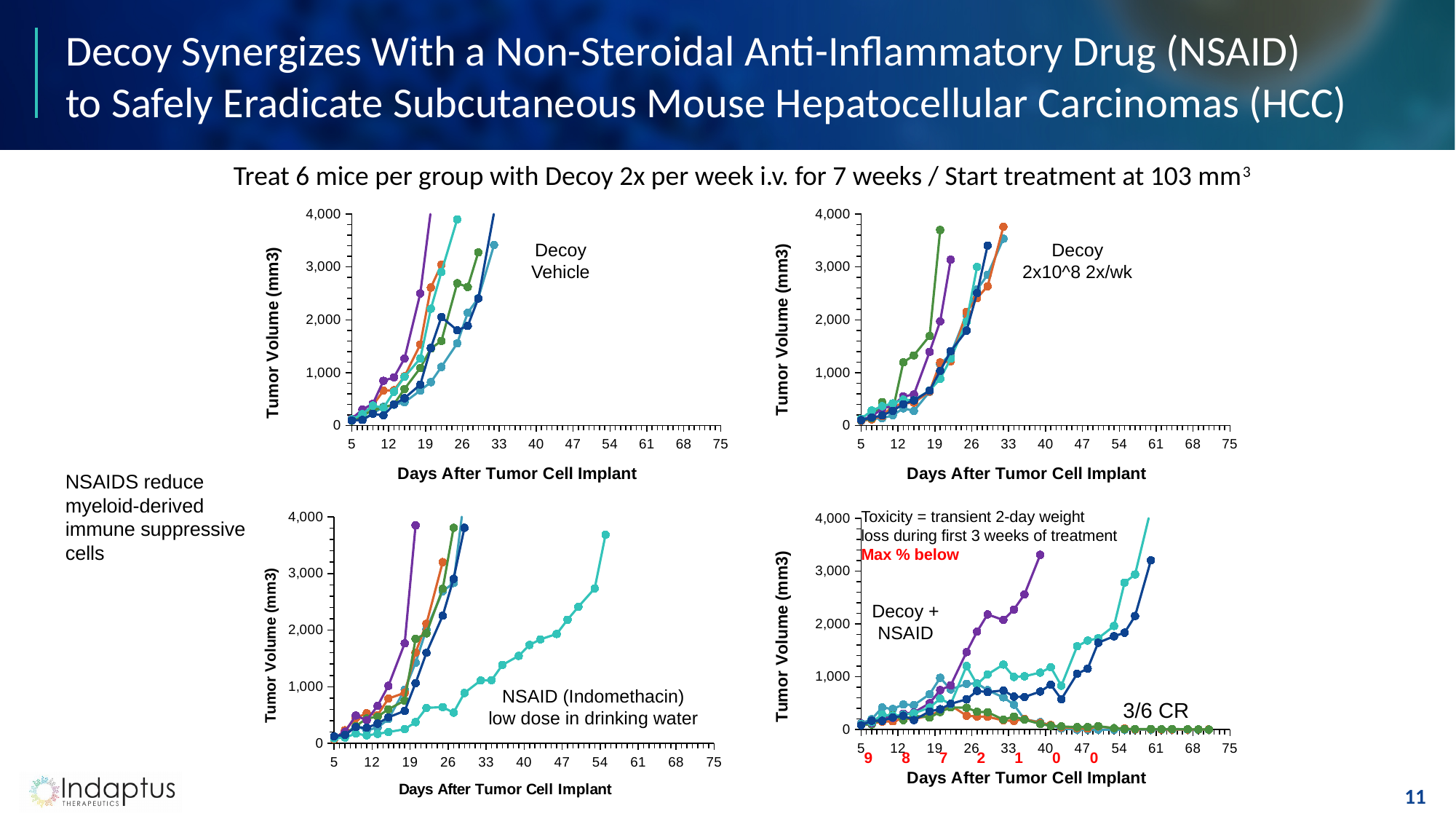
What kind of chart is the Decoy Vehicle chart at the top left? line chart In the Decoy + NSAID chart, what is the smallest of the red maximum % weight loss values printed below the x axis? 0 In the NSAID (Indomethacin) chart, is the final value of the teal line near day 54 greater or less than 3,000? greater In the Decoy + NSAID chart, is the value of the green line at day 68 greater or less than 1,000? less What is the highest value shown on the y axis of the Decoy + NSAID chart? 4,000 In the Decoy + NSAID chart, what is the first red maximum % weight loss value printed below the x axis? 9 What is the y-axis label on the Decoy 2x10^8 2x/wk chart? Tumor Volume (mm3) How many charts are shown on the slide? 4 In the Decoy + NSAID chart, is the highest point of the purple line greater or less than 3,000? greater In the Decoy + NSAID chart, how many complete responses (CR) are reported out of 6 mice? 3/6 CR In the Decoy + NSAID chart, what is the largest of the red maximum % weight loss values printed below the x axis? 9 In the Decoy Vehicle chart, do tumor volumes rise or fall as days after tumor cell implant increase? rise